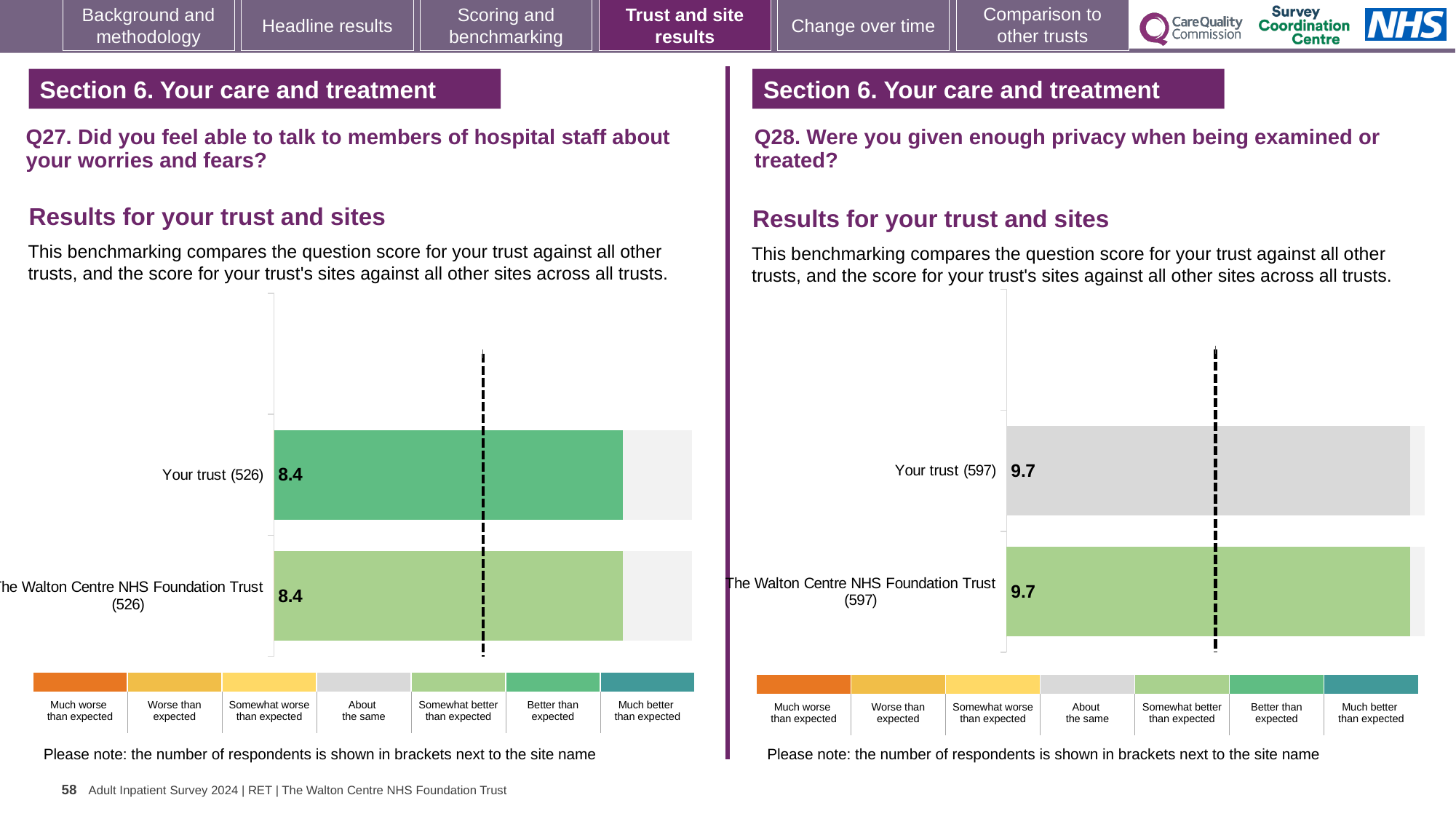
In the Q28 chart on the right, which benchmark category does the colour of the Your trust (597) bar correspond to? About the same In the Q28 chart on the right, what is the score for Your trust (597)? 9.7 In the Q27 chart on the left, what is the difference between the score for Your trust (526) and the score for The Walton Centre NHS Foundation Trust (526)? 0 Which is larger: the Your trust score in the Q28 chart on the right or the Your trust score in the Q27 chart on the left? Q28 chart (9.7) What kind of chart is the Q27 chart on the left? Bar chart In the Q27 chart on the left, what is the score for Your trust (526)? 8.4 In the Q28 chart on the right, how many bars are plotted? 2 In the Q28 chart on the right, how many respondents are shown in brackets next to Your trust? 597 In the Q27 chart on the left, which benchmark category does the colour of the Your trust (526) bar correspond to? Better than expected In the Q28 chart on the right, what is the score for The Walton Centre NHS Foundation Trust (597)? 9.7 In the Q27 chart on the left, how many bars are plotted? 2 In the Q27 chart on the left, what is the score for The Walton Centre NHS Foundation Trust (526)? 8.4